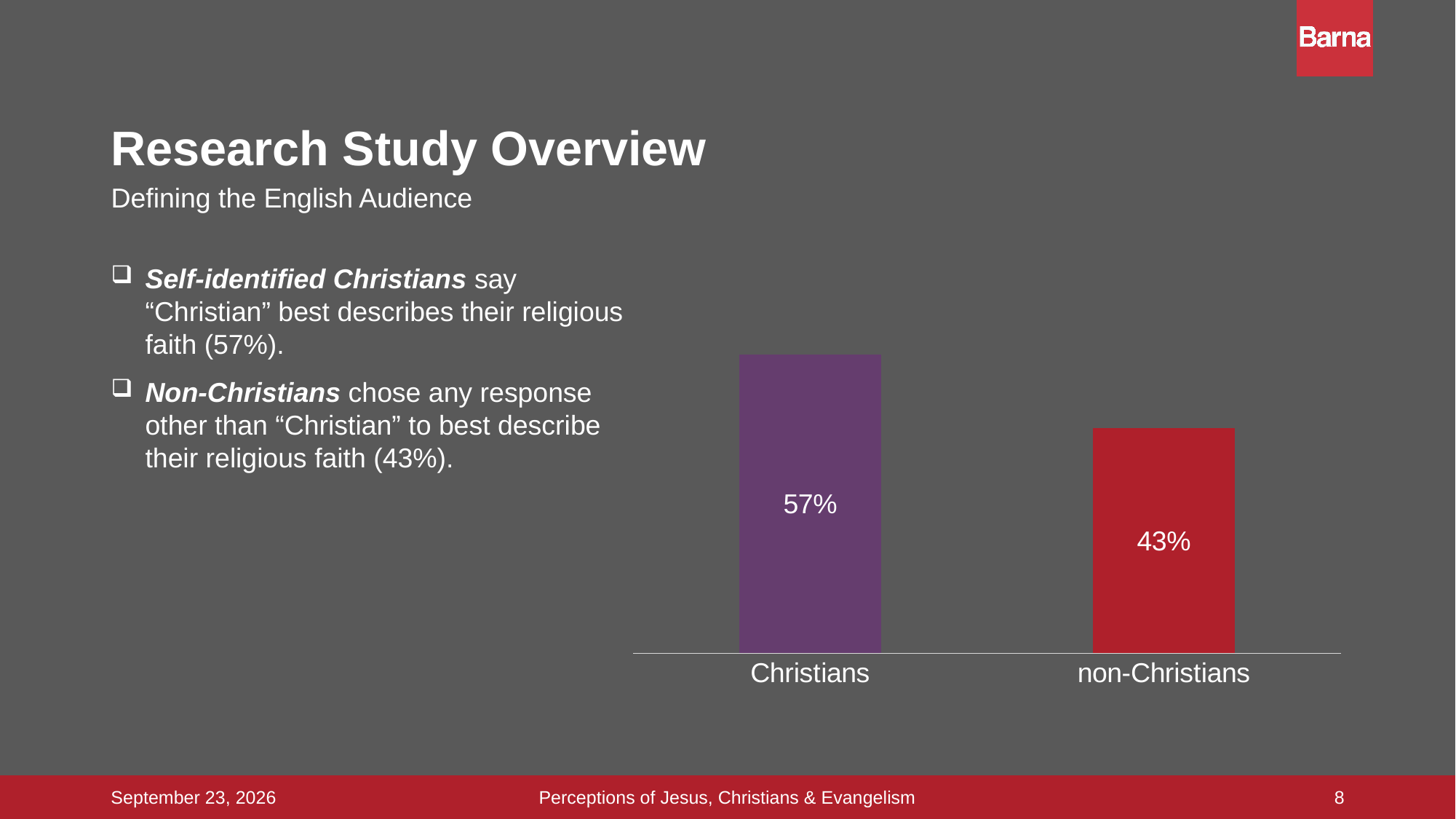
What is the difference between the values for Christians and non-Christians? 14% Which category has the highest value? Christians What is the value for non-Christians? 43% How many categories are shown in the chart? 2 What is the value for Christians? 57% Which category has the lowest value? non-Christians What is the total of the two values shown in the chart? 100% What colour is the bar for non-Christians? red Which is larger, the value for Christians or the value for non-Christians? Christians What kind of chart is shown on the slide? bar chart What colour is the bar for Christians? purple